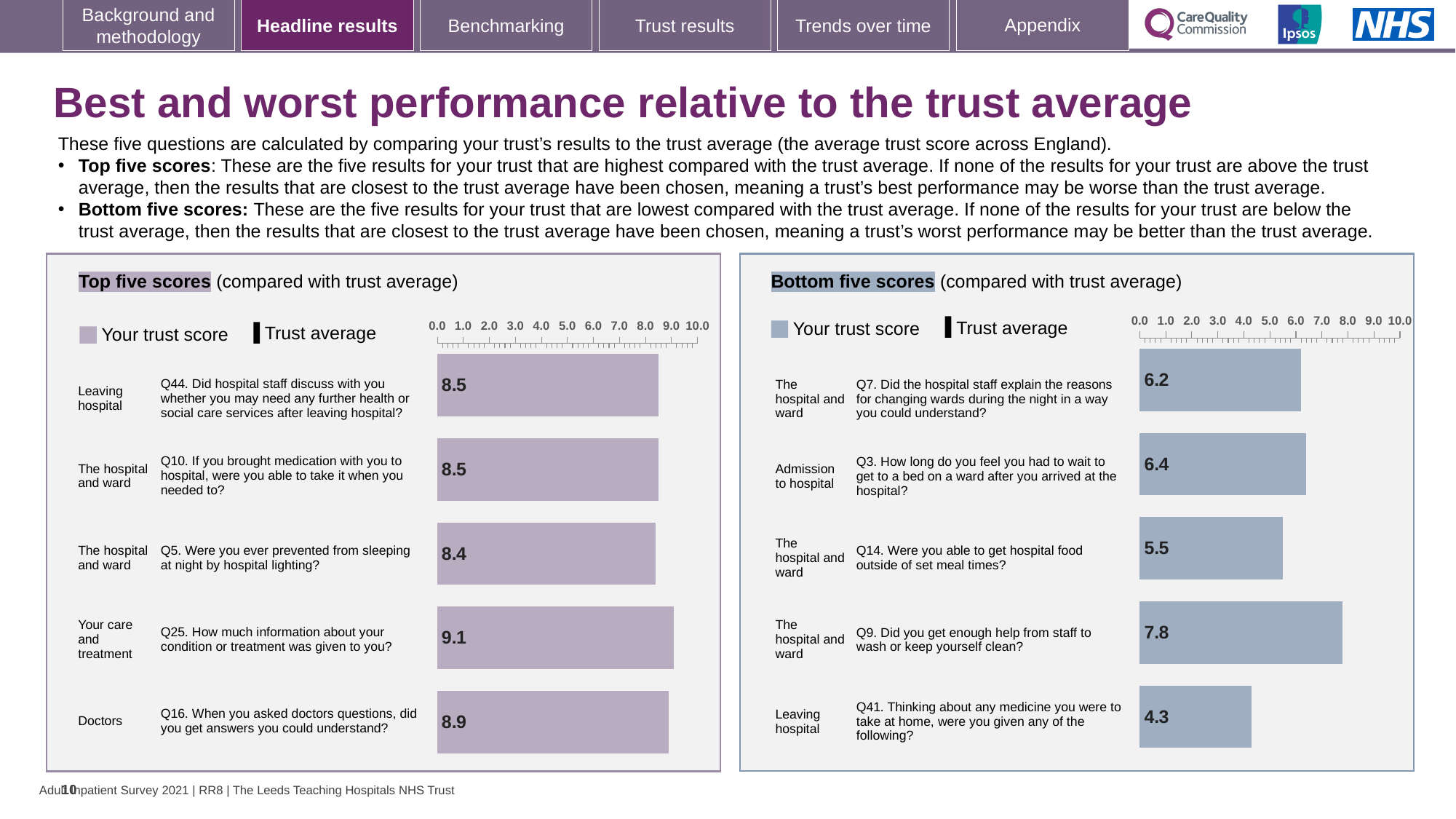
In the Top five scores chart, which question has the highest trust score? Q25 In the Bottom five scores chart, what is the trust score for Q41 (Thinking about any medicine you were to take at home, were you given any of the following)? 4.3 What type of chart is used for the Top five scores? Bar chart In the Bottom five scores chart, which question has the lowest trust score? Q41 In the Bottom five scores chart, which question has the highest trust score? Q9 In the Top five scores chart, what is the trust score for Q25 (How much information about your condition or treatment was given to you)? 9.1 In the Bottom five scores chart, which has the larger trust score, Q7 or Q3? Q3 In the Top five scores chart, is the trust score for Q16 greater or less than 8.0? greater How many series does the legend of the Top five scores chart list? 2 How many questions are shown in the Bottom five scores chart? 5 In the Bottom five scores chart, what is the difference between the trust scores for Q9 and Q41? 3.5 In the Top five scores chart, what is the difference between the trust scores for Q25 and Q5? 0.7